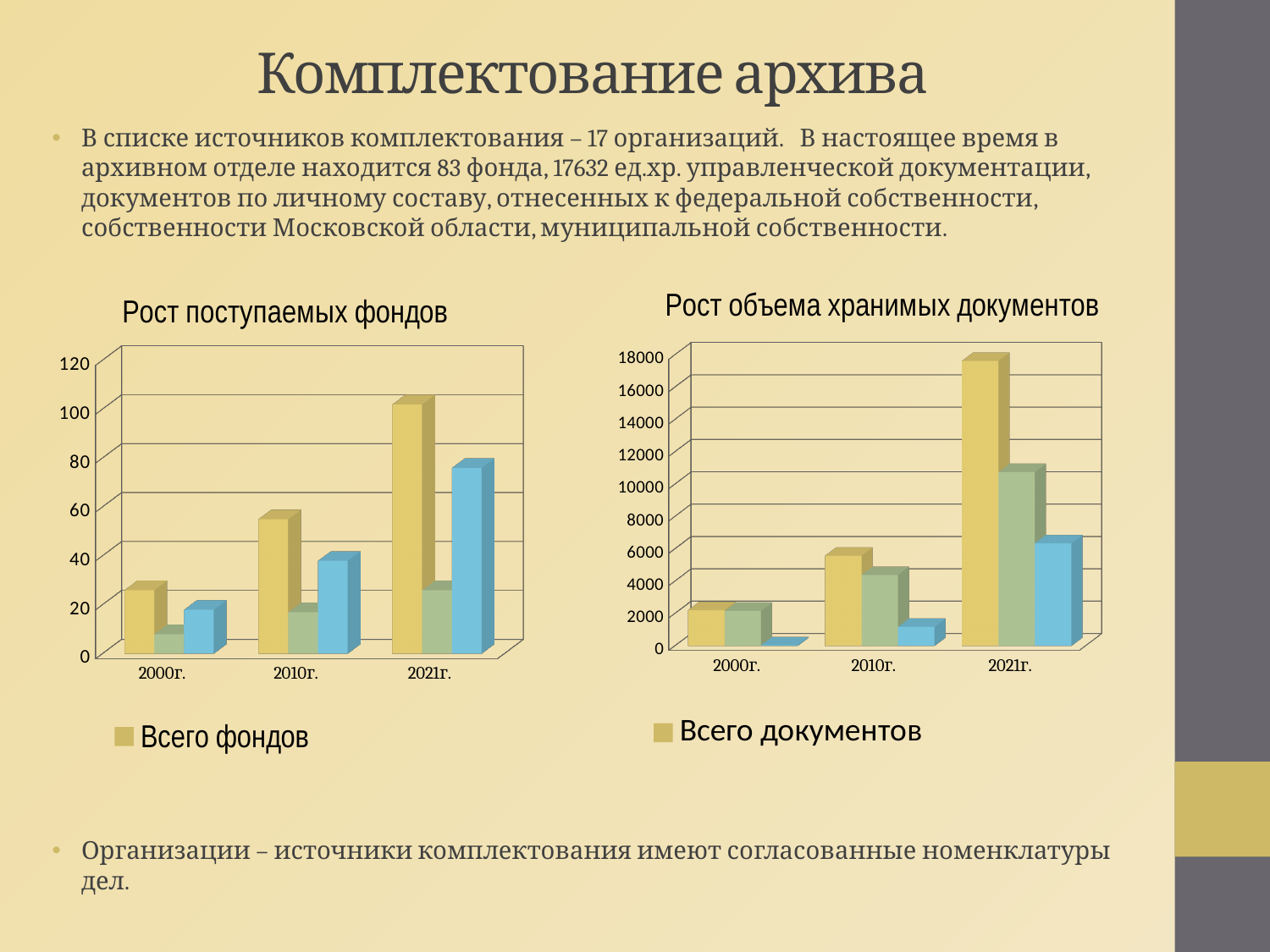
How many categories are shown on the x axis of the "Рост объема хранимых документов" chart? 3 In the "Рост объема хранимых документов" chart, do the values for "Всего документов" rise or fall from 2000г. to 2021г.? rise What is the title of the chart on the right side of the slide? Рост объема хранимых документов In the "Рост объема хранимых документов" chart, is the value for "Всего документов" in 2021г. greater or less than 16000? greater In the "Рост объема хранимых документов" chart, is the value for "Всего документов" in 2010г. greater or less than 8000? less What legend entry is shown below the "Рост поступаемых фондов" chart? Всего фондов In the "Рост поступаемых фондов" chart, is the value for "Всего фондов" in 2000г. greater or less than 40? less In the "Рост поступаемых фондов" chart, which year has the highest value for "Всего фондов"? 2021г. What kind of chart is "Рост поступаемых фондов"? bar chart In the "Рост объема хранимых документов" chart, which is larger for "Всего документов": 2010г. or 2021г.? 2021г. In the "Рост поступаемых фондов" chart, which year has the lowest value for "Всего фондов"? 2000г.